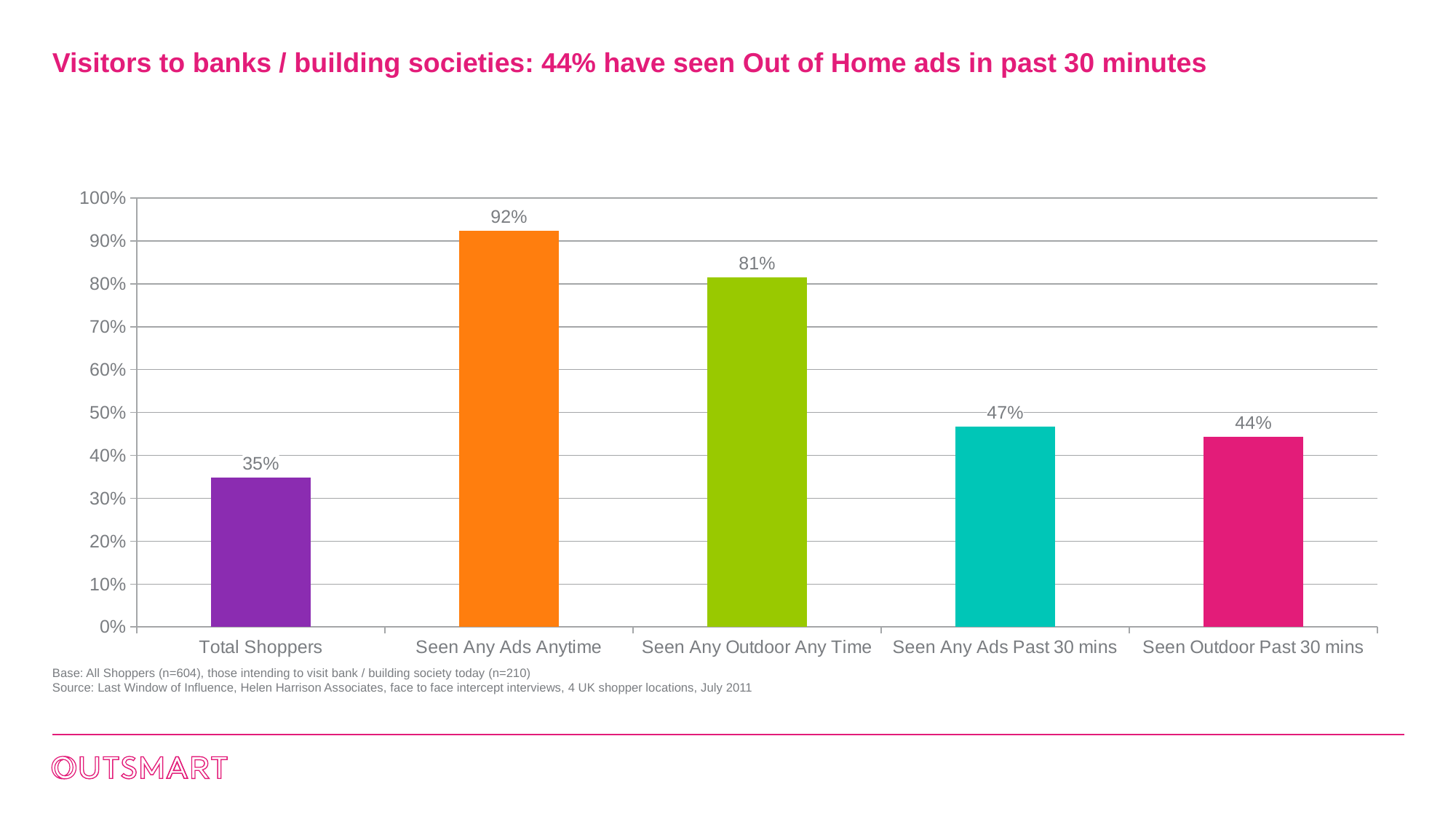
What colour is the bar for Seen Any Ads Anytime? Orange What kind of chart is shown on the slide? Bar chart What is the value for Total Shoppers? 35% Which category has the lowest value? Total Shoppers What is the value for Seen Any Ads Anytime? 92% What is the value for Seen Any Outdoor Any Time? 81% What is the value for Seen Outdoor Past 30 mins? 44% How many categories are shown on the x axis? 5 Which is larger, Seen Any Outdoor Any Time or Seen Any Ads Past 30 mins? Seen Any Outdoor Any Time What is the difference between Seen Any Ads Anytime and Seen Any Outdoor Any Time? 11% What is the difference between Seen Any Ads Past 30 mins and Seen Outdoor Past 30 mins? 3% Which category has the highest value? Seen Any Ads Anytime